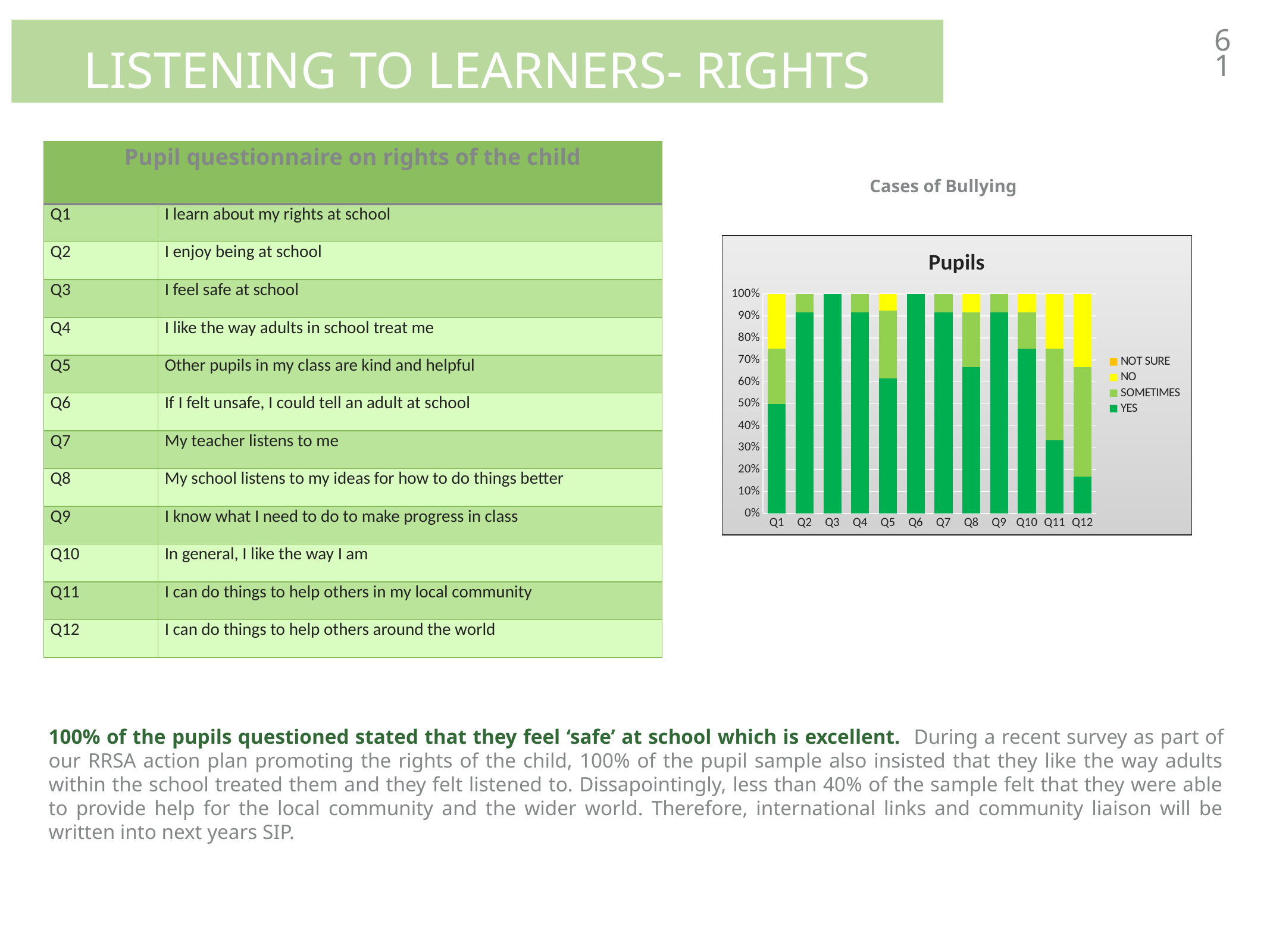
Which has the larger YES share, Q11 or Q12? Q11 What is the title shown inside the chart area? Pupils Is the YES value for Q12 greater or less than 30%? less Which legend entry is shown in yellow? NO Which has the larger YES share, Q1 or Q2? Q2 How many series does the legend of the Pupils chart list? 4 What is the YES value for Q3 in the Pupils chart? 100% Is the YES value for Q11 greater or less than 40%? less Is the YES value for Q1 greater or less than 40%? greater Which question has the lowest YES share in the Pupils chart? Q12 How many questions (categories) are plotted along the x axis of the Pupils chart? 12 What kind of chart is shown on the slide? Stacked bar chart